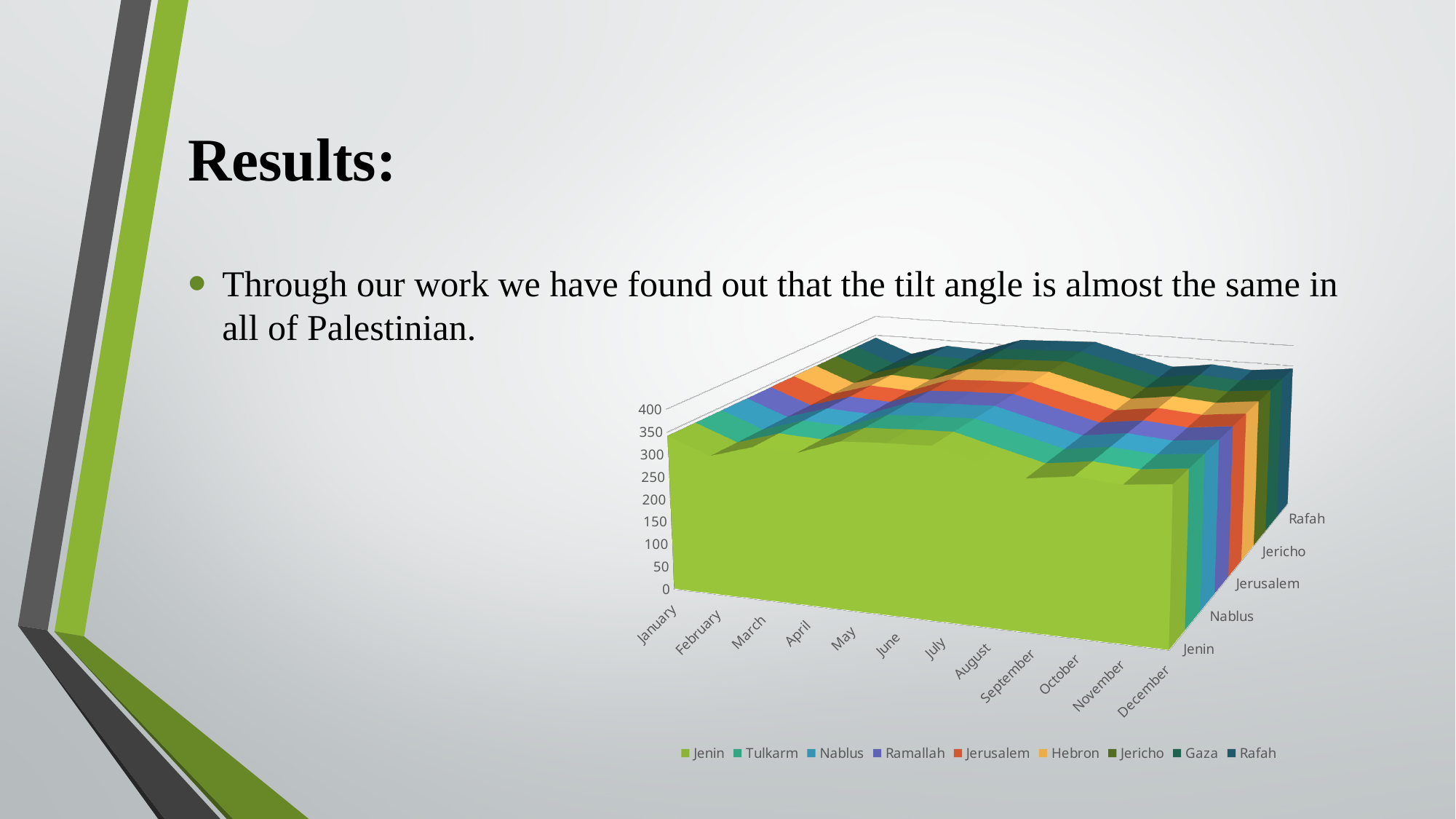
Which month is the first category on the x axis? January Which series is listed first in the legend? Jenin What kind of chart is shown on the slide? 3D area chart Which series is listed last in the legend? Rafah Is the value for Jenin in December greater or less than 100? greater Is the value for Jenin in January greater or less than 200? greater How many series does the legend list? 9 How many months are shown along the x axis? 12